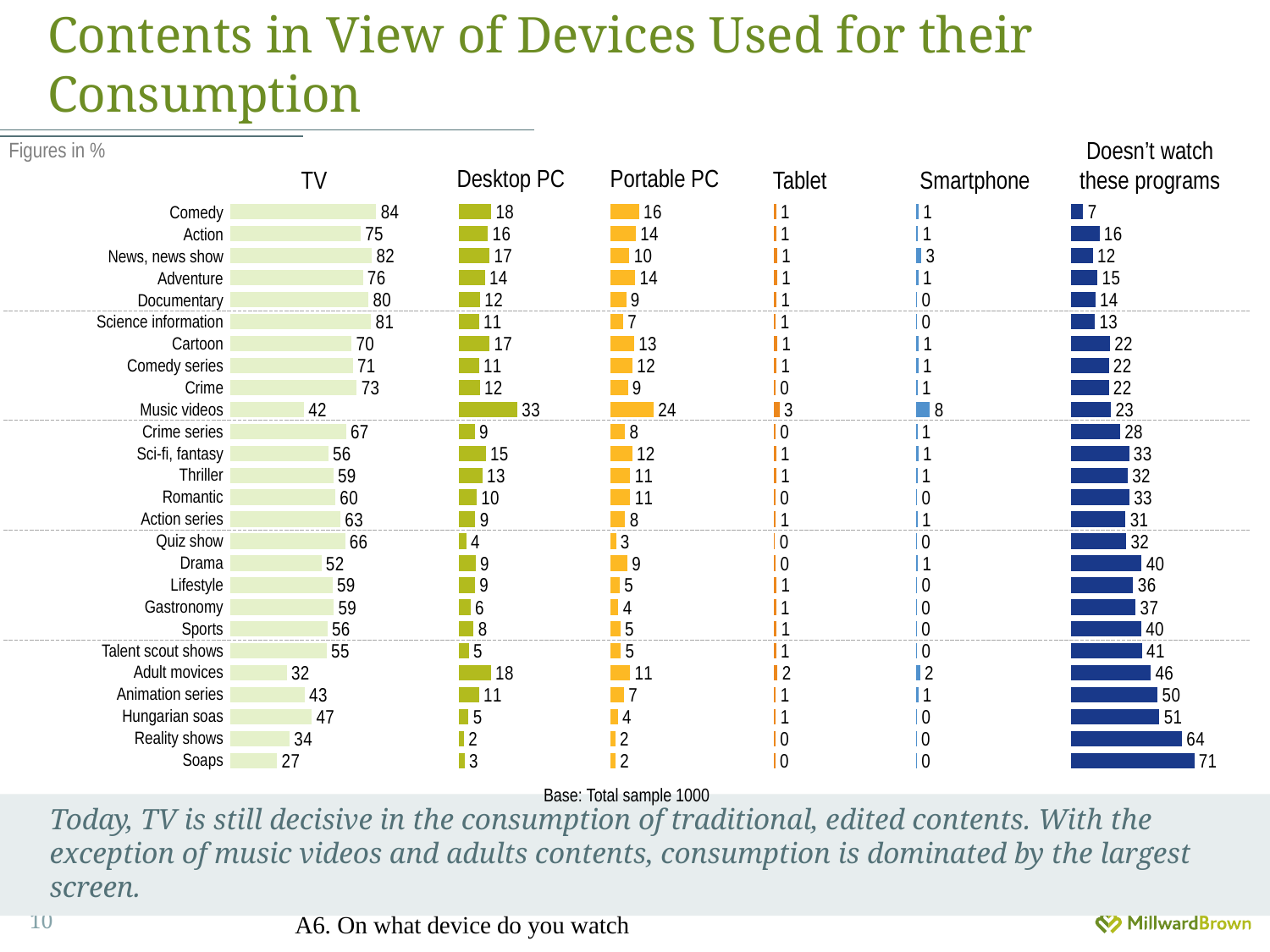
In the TV chart, what is the difference between the values for Comedy and Soaps? 57 In the Desktop PC chart, what is the value for Music videos? 33 In the TV chart, what is the value for Comedy? 84 In the TV chart, which category has the highest value? Comedy In the 'Doesn't watch these programs' chart, which category has the highest value? Soaps What kind of chart is the TV chart? Bar chart How many categories are listed in the TV chart? 26 In the Desktop PC chart, which is larger, the value for Comedy or the value for Quiz show? Comedy In the TV chart, which category has the lowest value? Soaps In the Smartphone chart, which category has the highest value? Music videos In the Portable PC chart, what is the value for Adult movices? 11 In the 'Doesn't watch these programs' chart, what is the value for Reality shows? 64